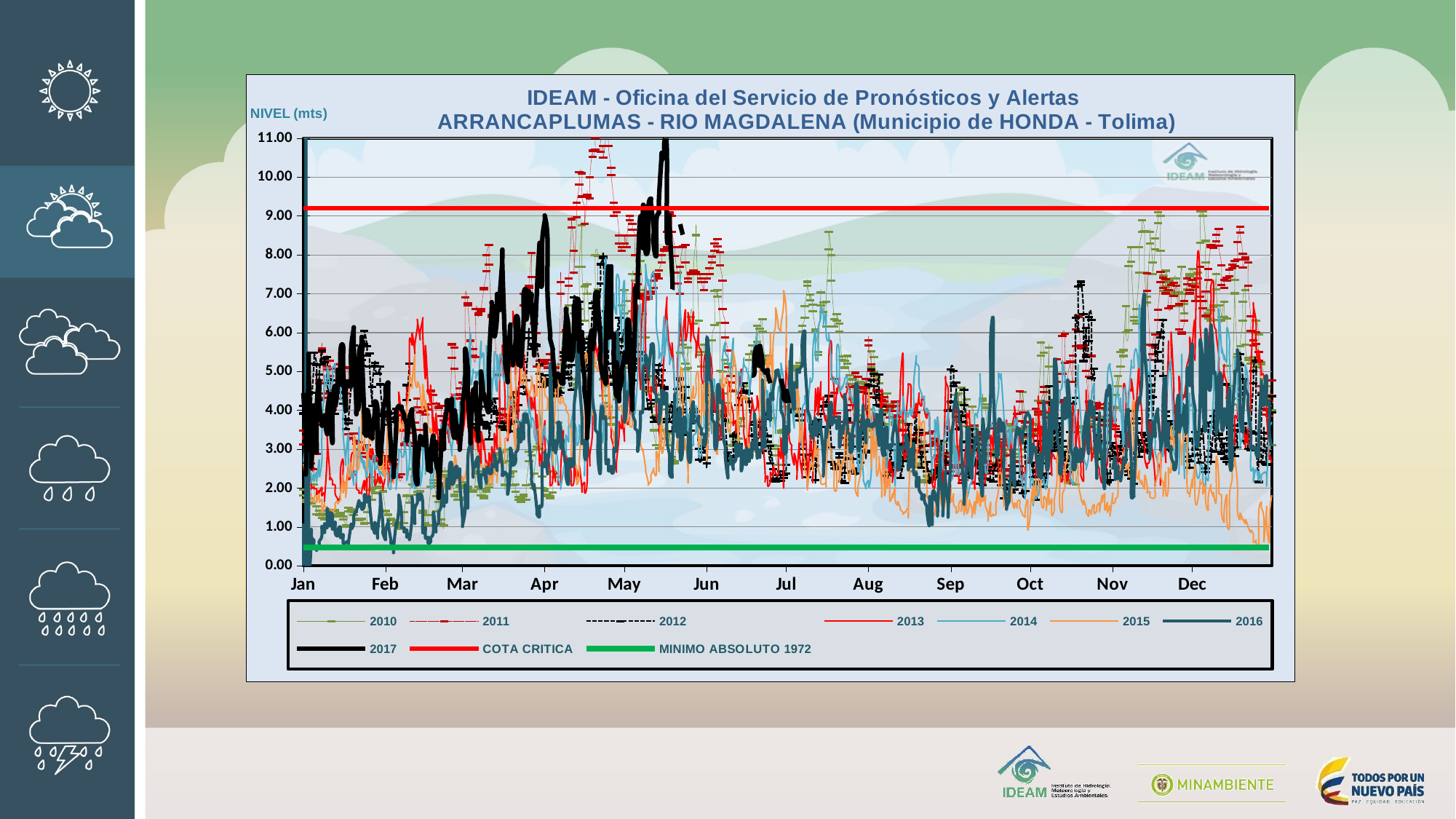
What colour is the COTA CRITICA line in the chart legend? Red How many entries does the chart legend list? 10 Which river station is named in the chart title? ARRANCAPLUMAS - RIO MAGDALENA (Municipio de HONDA - Tolima) What is the label of the vertical axis of the chart? NIVEL (mts) What kind of chart is shown on the slide? Line chart How many months are labelled along the x axis of the chart? 12 What is the highest value shown on the vertical axis of the chart? 11.00 Is the COTA CRITICA line greater or less than 9.00 on the vertical axis? greater Which of the two reference lines is higher on the chart, COTA CRITICA or MINIMO ABSOLUTO 1972? COTA CRITICA Is the peak of the 2017 series in late May greater or less than 10.00? greater Is the MINIMO ABSOLUTO 1972 line greater or less than 1.00 on the vertical axis? less How many year series (2010 through 2017) are plotted on the chart? 8